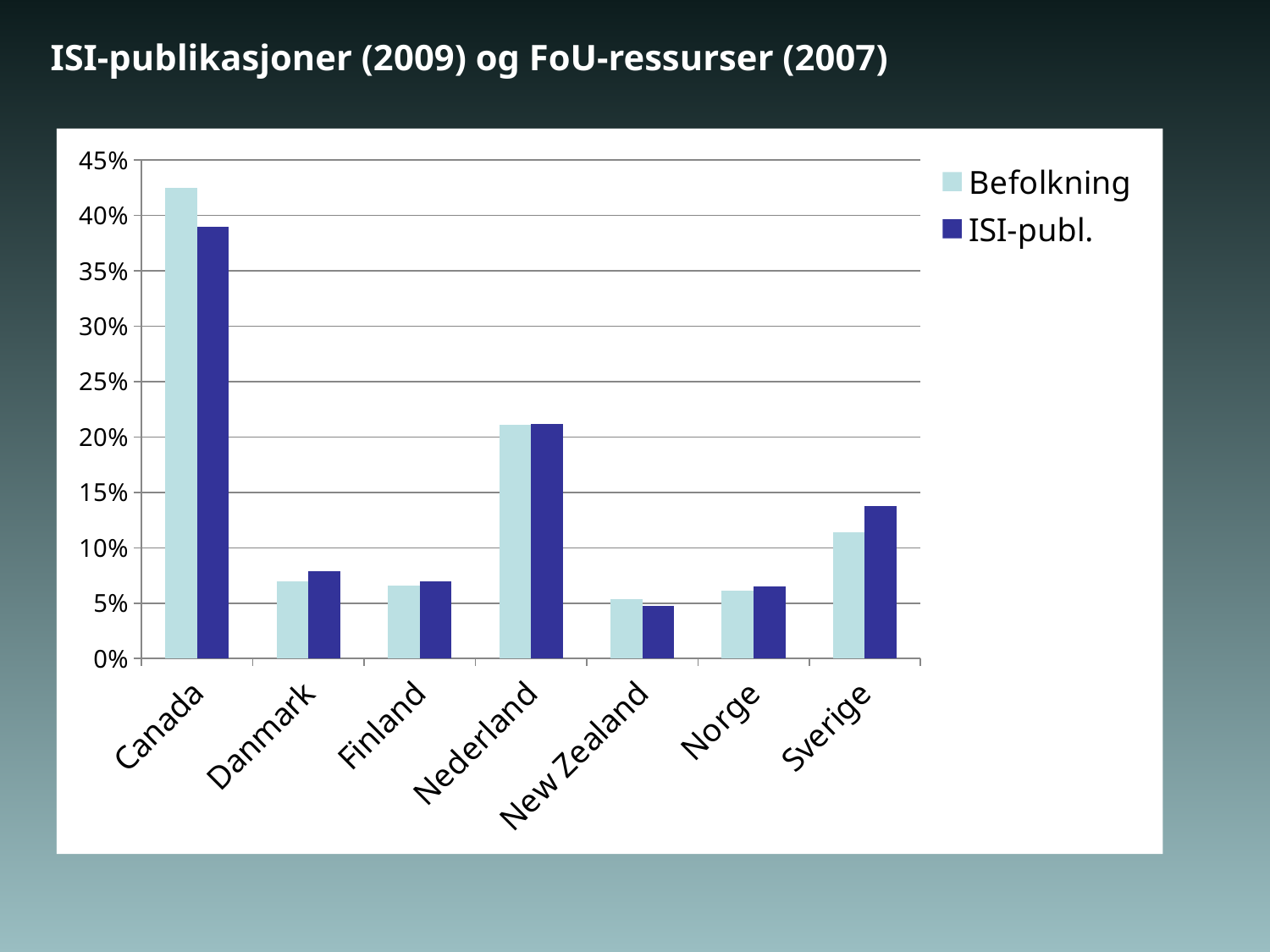
What is the title of the slide? ISI-publikasjoner (2009) og FoU-ressurser (2007) What kind of chart is shown on the slide? bar chart For Canada, which is larger: Befolkning or ISI-publ.? Befolkning Which country has the highest ISI-publ. value? Canada Which country has the highest Befolkning value? Canada Is the ISI-publ. value for Nederland greater or less than 20%? greater Is the ISI-publ. value for Sverige greater or less than 15%? less Which country has the lowest ISI-publ. value? New Zealand For Sverige, which is larger: Befolkning or ISI-publ.? ISI-publ. How many countries are shown on the x axis? 7 How many series does the legend list? 2 Is the Befolkning value for Canada greater or less than 40%? greater